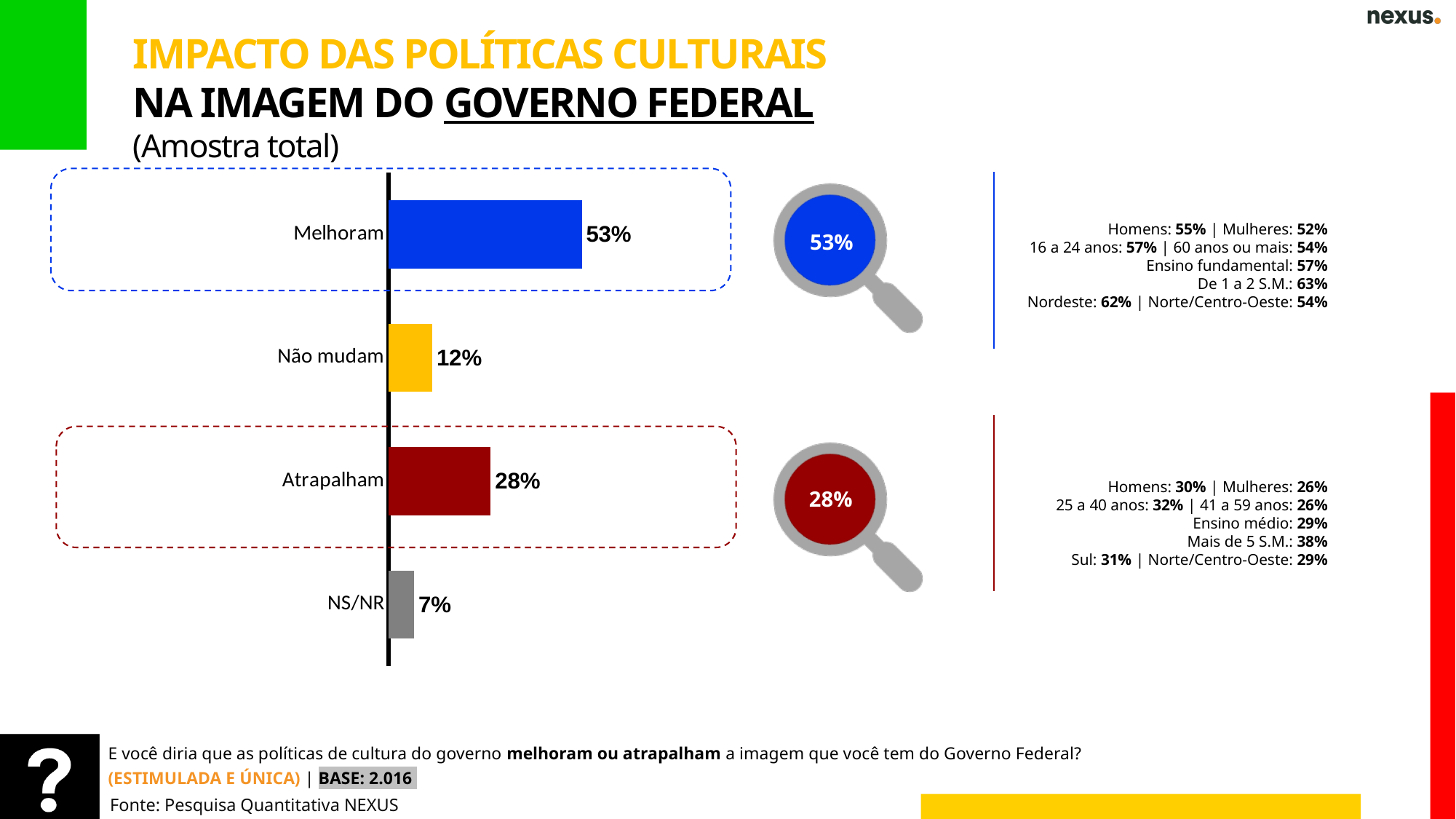
Which is larger, the value for Atrapalham or the value for Não mudam? Atrapalham What is the value for Melhoram? 53% What is the value for Atrapalham? 28% What colour is the bar for Atrapalham? Dark red What is the value for NS/NR? 7% How many categories are shown in the bar chart? 4 What kind of chart is shown on the slide? Bar chart What is the value for Não mudam? 12% What is the difference between the values for Melhoram and Atrapalham? 25% Which category has the lowest value? NS/NR What is the difference between the values for Não mudam and NS/NR? 5% Which category has the highest value? Melhoram